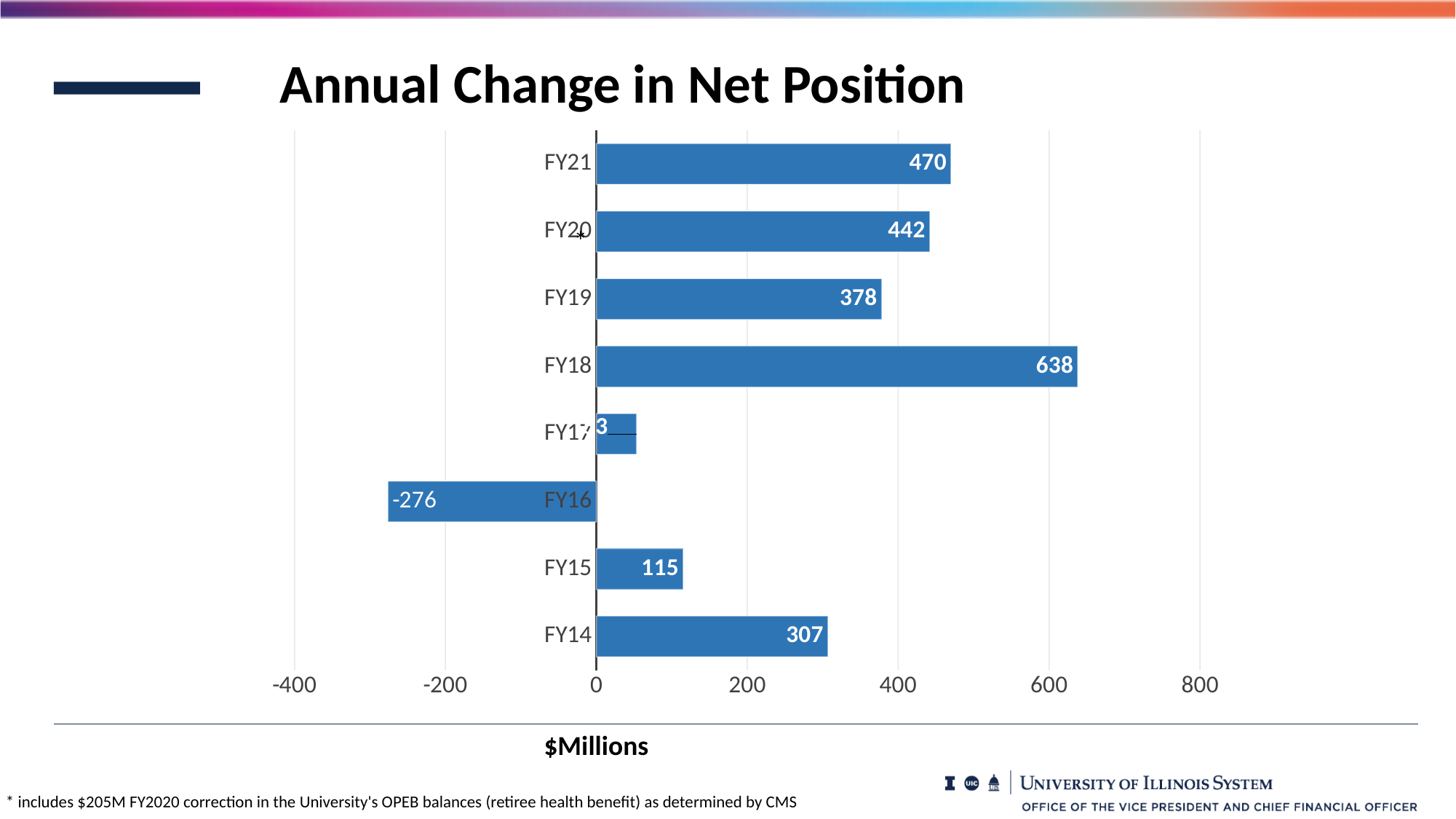
What is the value for FY18? 638 What is the value for FY16? -276 What kind of chart is shown on the slide? bar chart Which is larger, the value for FY20 or the value for FY14? FY20 What is the value for FY15? 115 How many fiscal years are shown in the chart? 8 Is the value for FY17 greater or less than 200? less What is the difference between the values for FY18 and FY19? 260 What is the value for FY21? 470 Which fiscal year has the highest annual change in net position? FY18 Which fiscal year has the lowest annual change in net position? FY16 What unit is given for the x axis of the chart? $Millions